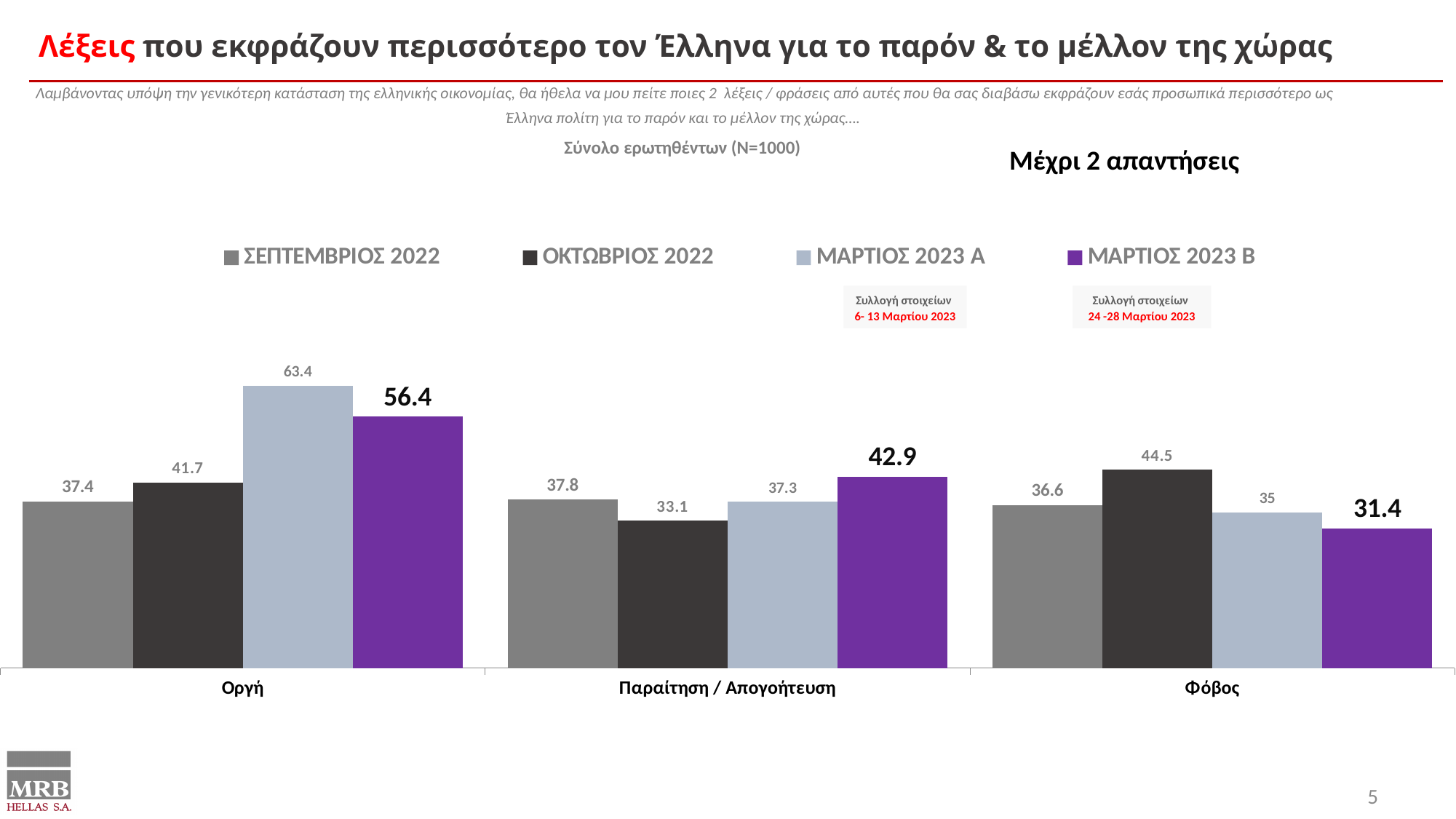
What is the difference between the ΜΑΡΤΙΟΣ 2023 Α and ΜΑΡΤΙΟΣ 2023 Β values for Οργή? 7 What is the value for Οργή in the ΜΑΡΤΙΟΣ 2023 Β series? 56.4 Do the values for Φόβος rise or fall from ΜΑΡΤΙΟΣ 2023 Α to ΜΑΡΤΙΟΣ 2023 Β? Fall What is the value for Φόβος in the ΟΚΤΩΒΡΙΟΣ 2022 series? 44.5 Which is larger for Παραίτηση / Απογοήτευση: the ΟΚΤΩΒΡΙΟΣ 2022 value or the ΜΑΡΤΙΟΣ 2023 Β value? ΜΑΡΤΙΟΣ 2023 Β How many series does the legend list? 4 What colour are the bars for the ΜΑΡΤΙΟΣ 2023 Β series? Purple Which category has the highest value in the ΜΑΡΤΙΟΣ 2023 Α series? Οργή Which category has the lowest value in the ΜΑΡΤΙΟΣ 2023 Β series? Φόβος What is the value for Παραίτηση / Απογοήτευση in the ΣΕΠΤΕΜΒΡΙΟΣ 2022 series? 37.8 How many categories are shown on the x axis? 3 What kind of chart is shown on the slide? Bar chart